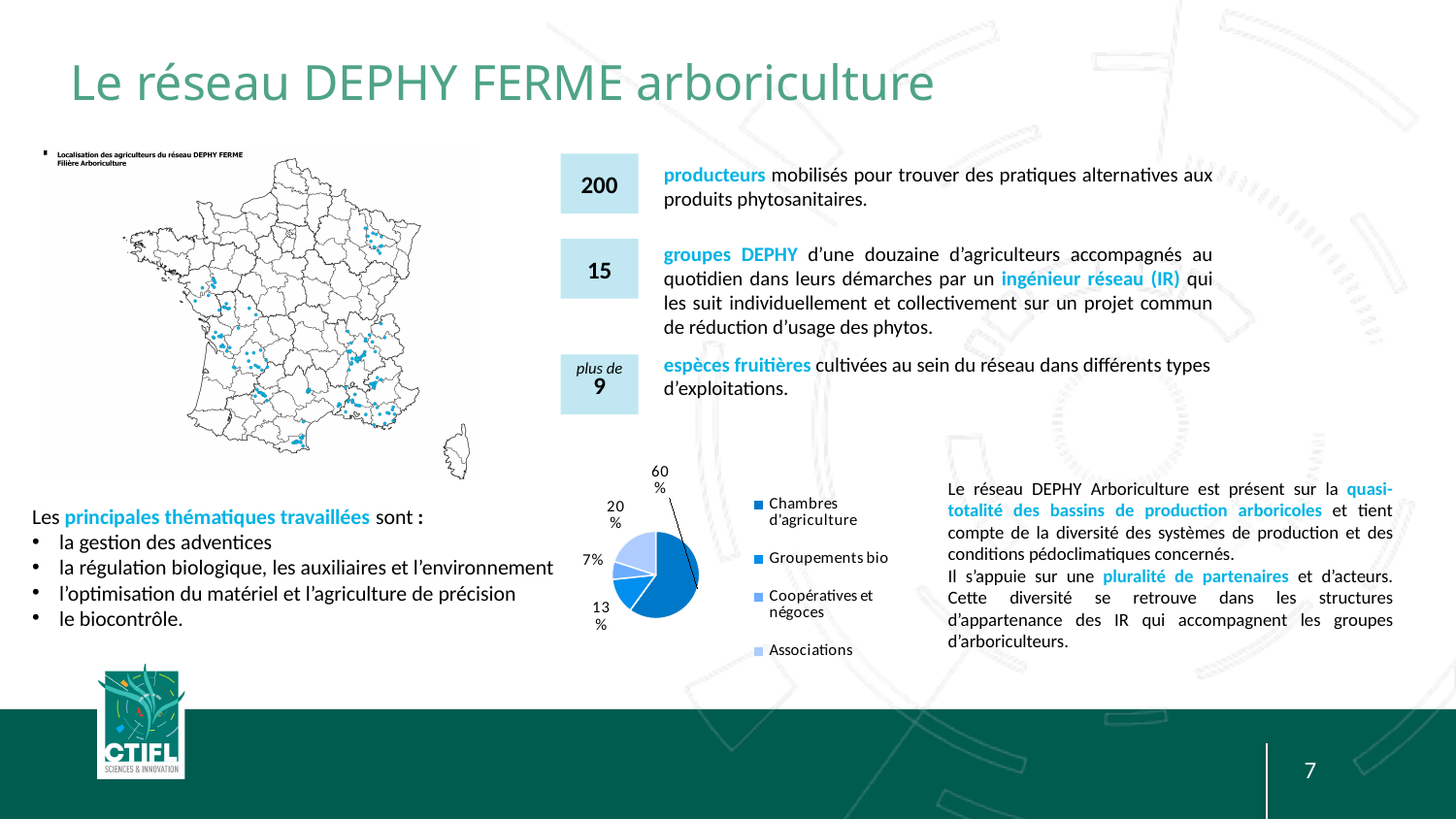
Which legend entry in the pie chart is shown in the darkest blue? Chambres d'agriculture In the pie chart, what share is labelled for Chambres d'agriculture? 60% How many categories does the pie chart legend list? 4 Which category has the smallest slice in the pie chart? Coopératives et négoces In the pie chart, what is the difference between the shares of Chambres d'agriculture and Associations? 40% In the pie chart, what share is labelled for Coopératives et négoces? 7% In the pie chart, what share is labelled for Associations? 20% What kind of chart is shown at the bottom centre of the slide? pie chart Which category has the largest slice in the pie chart? Chambres d'agriculture In the pie chart, which is larger: the share of Groupements bio or the share of Associations? Associations In the pie chart, what is the difference between the shares of Groupements bio and Coopératives et négoces? 6%